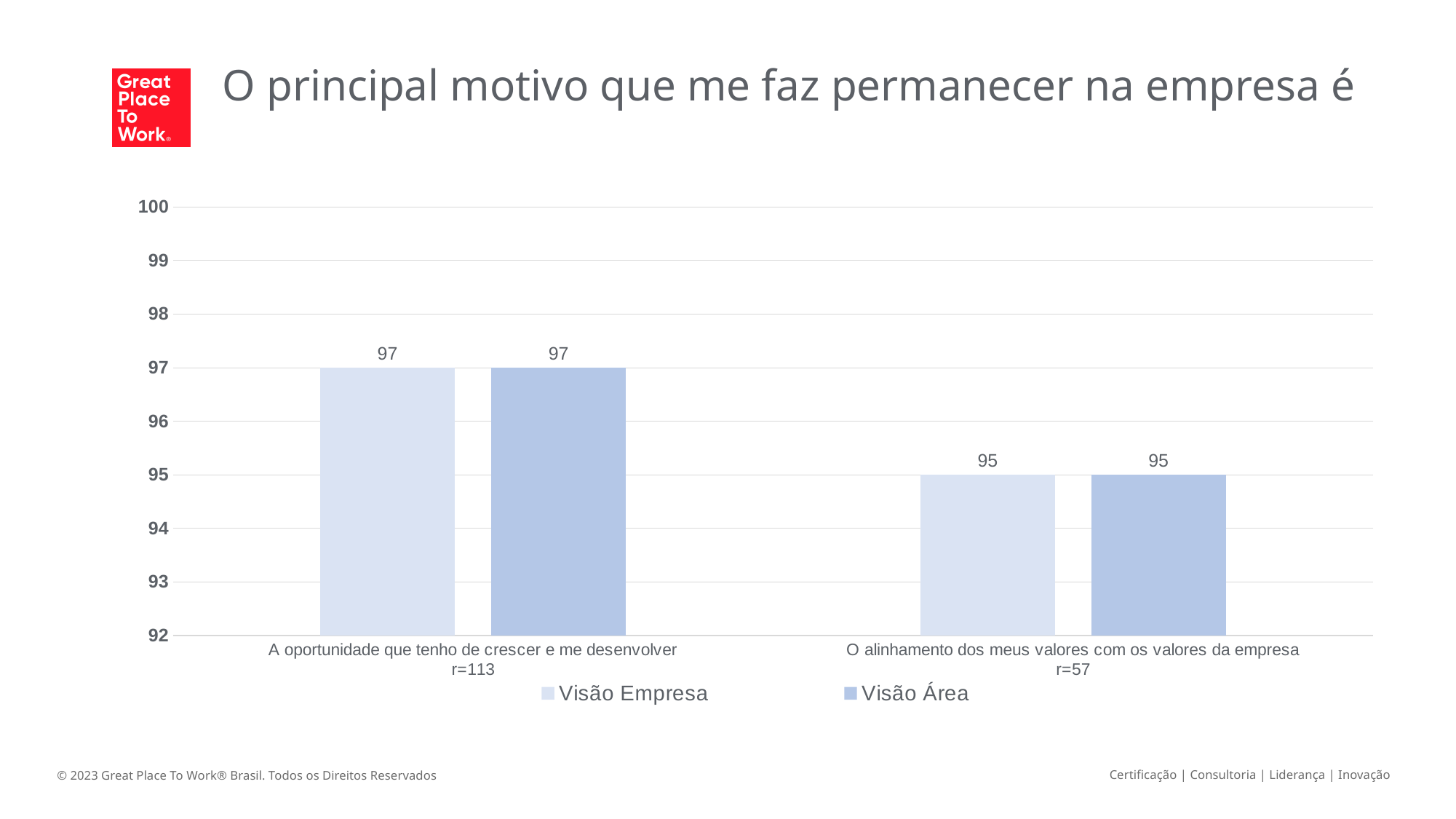
How many categories are shown on the x axis? 2 What is the title of the slide? O principal motivo que me faz permanecer na empresa é What is the Visão Empresa value for "A oportunidade que tenho de crescer e me desenvolver"? 97 What is the Visão Área value for "O alinhamento dos meus valores com os valores da empresa"? 95 Which is larger: the Visão Área value for "A oportunidade que tenho de crescer e me desenvolver" or for "O alinhamento dos meus valores com os valores da empresa"? A oportunidade que tenho de crescer e me desenvolver What is the difference between the Visão Empresa values for "A oportunidade que tenho de crescer e me desenvolver" and "O alinhamento dos meus valores com os valores da empresa"? 2 How many series does the legend list? 2 Which category has the lowest Visão Empresa value? O alinhamento dos meus valores com os valores da empresa Which category has the highest Visão Área value? A oportunidade que tenho de crescer e me desenvolver What is the Visão Empresa value for "O alinhamento dos meus valores com os valores da empresa"? 95 What is the r value shown under "O alinhamento dos meus valores com os valores da empresa"? r=57 What kind of chart is shown on the slide? Bar chart